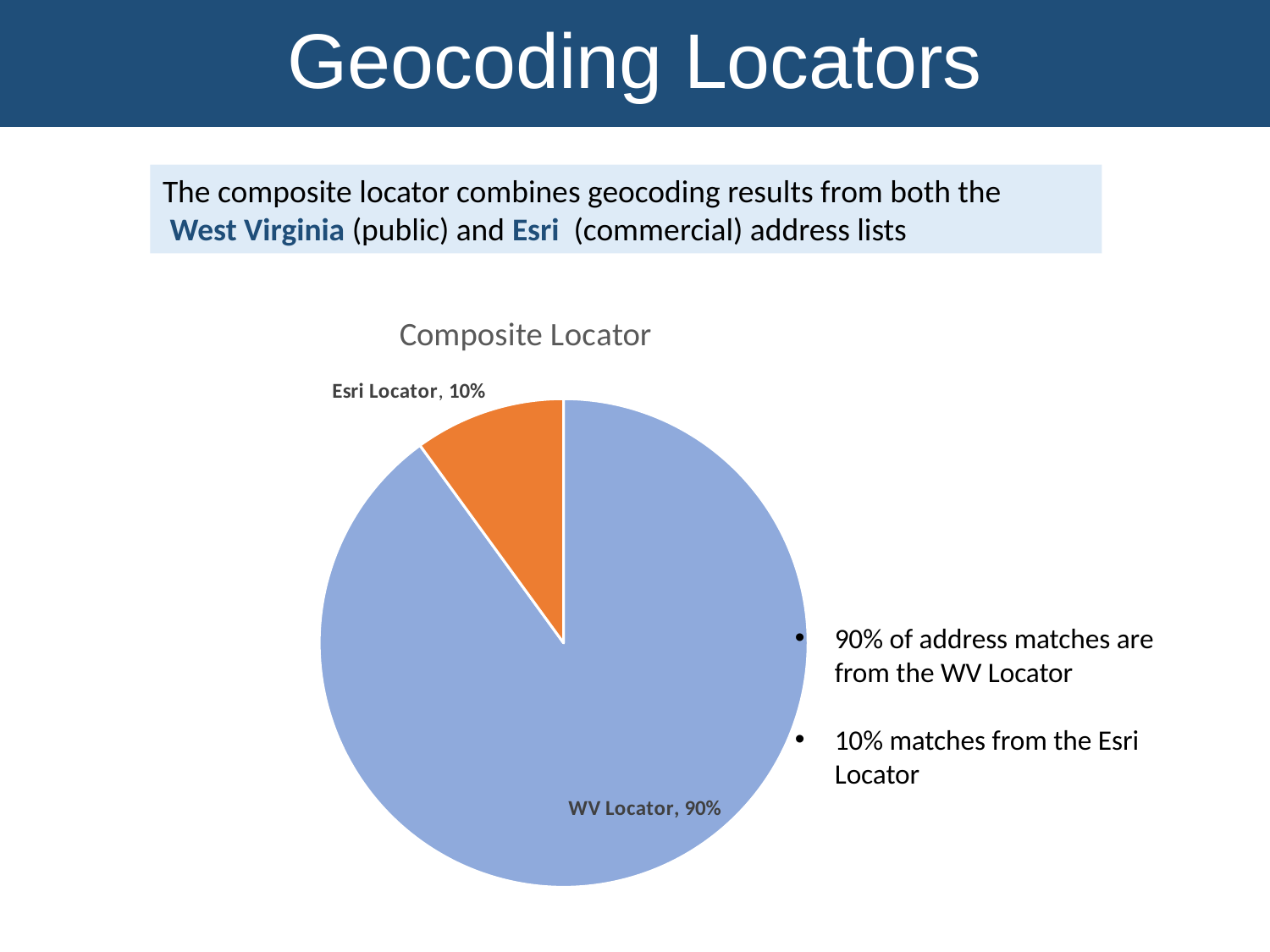
Which slice of the pie is the smallest? Esri Locator What share of the pie does the WV Locator slice represent? 90% What type of chart is shown on the slide? pie chart How many slices does the pie chart have? 2 Which is larger, the WV Locator slice or the Esri Locator slice? WV Locator What is the title of the chart? Composite Locator What share of the pie does the Esri Locator slice represent? 10% Which slice of the pie is the largest? WV Locator What colour is the Esri Locator slice? orange What is the total of the two slices shown in the pie chart? 100% What is the difference in percentage points between the WV Locator and Esri Locator slices? 80%